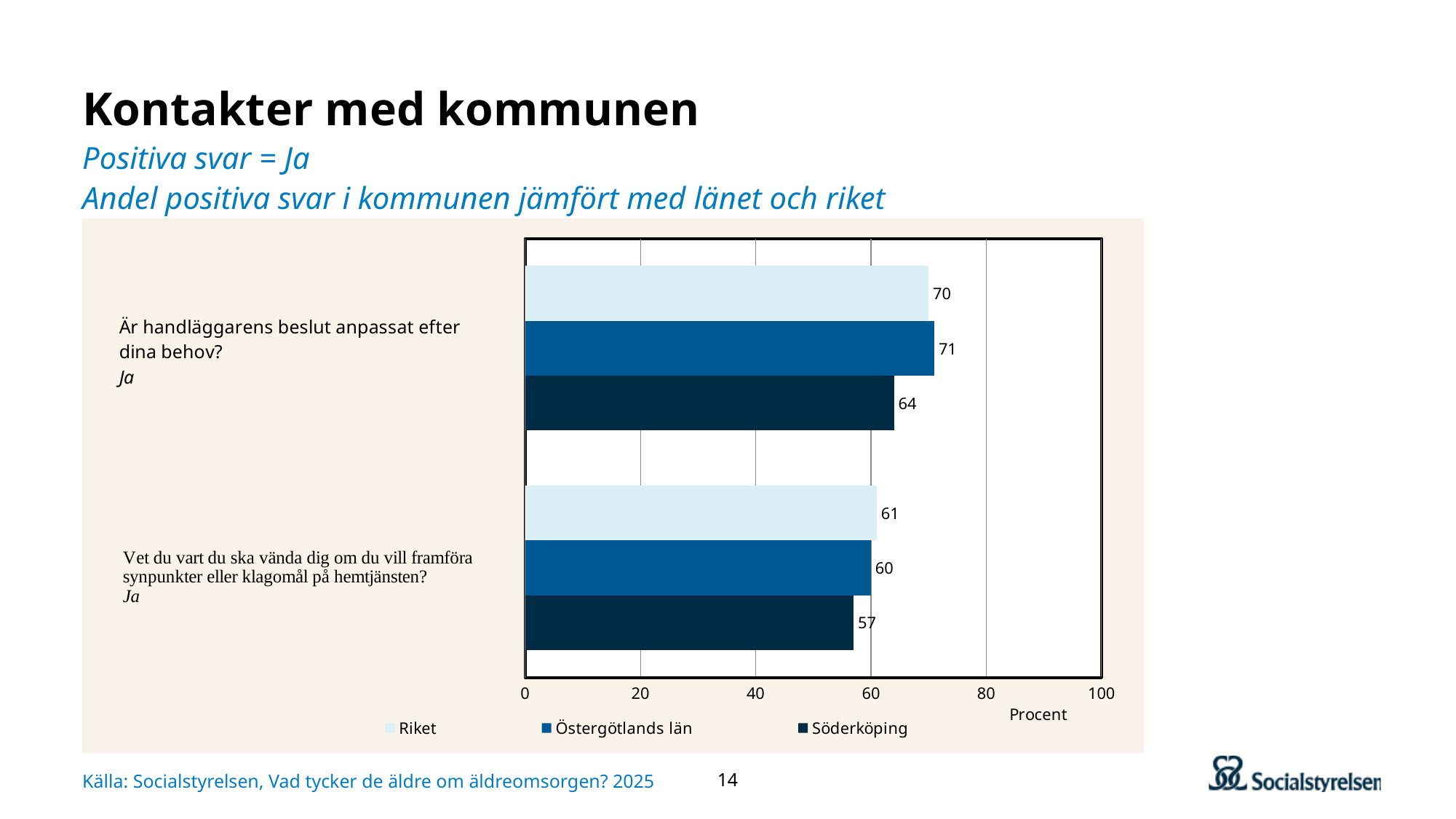
What is the difference between Riket and Söderköping on the question "Vet du vart du ska vända dig om du vill framföra synpunkter eller klagomål på hemtjänsten?"? 4 What is the value for Söderköping on the question "Är handläggarens beslut anpassat efter dina behov?"? 64 How many series does the legend list? 3 What is the value for Riket on the question "Vet du vart du ska vända dig om du vill framföra synpunkter eller klagomål på hemtjänsten?"? 61 Which series has the lowest value on the question "Vet du vart du ska vända dig om du vill framföra synpunkter eller klagomål på hemtjänsten?"? Söderköping What is the difference between Östergötlands län and Söderköping on the question "Är handläggarens beslut anpassat efter dina behov?"? 7 Is the value for Riket on "Är handläggarens beslut anpassat efter dina behov?" greater or less than 60? greater Which is larger for Söderköping: the value for "Är handläggarens beslut anpassat efter dina behov?" or for "Vet du vart du ska vända dig om du vill framföra synpunkter eller klagomål på hemtjänsten?"? Är handläggarens beslut anpassat efter dina behov? What is the label on the horizontal axis of the chart? Procent What kind of chart is shown on the slide? Bar chart Which series has the highest value on the question "Är handläggarens beslut anpassat efter dina behov?"? Östergötlands län What is the value for Östergötlands län on the question "Är handläggarens beslut anpassat efter dina behov?"? 71